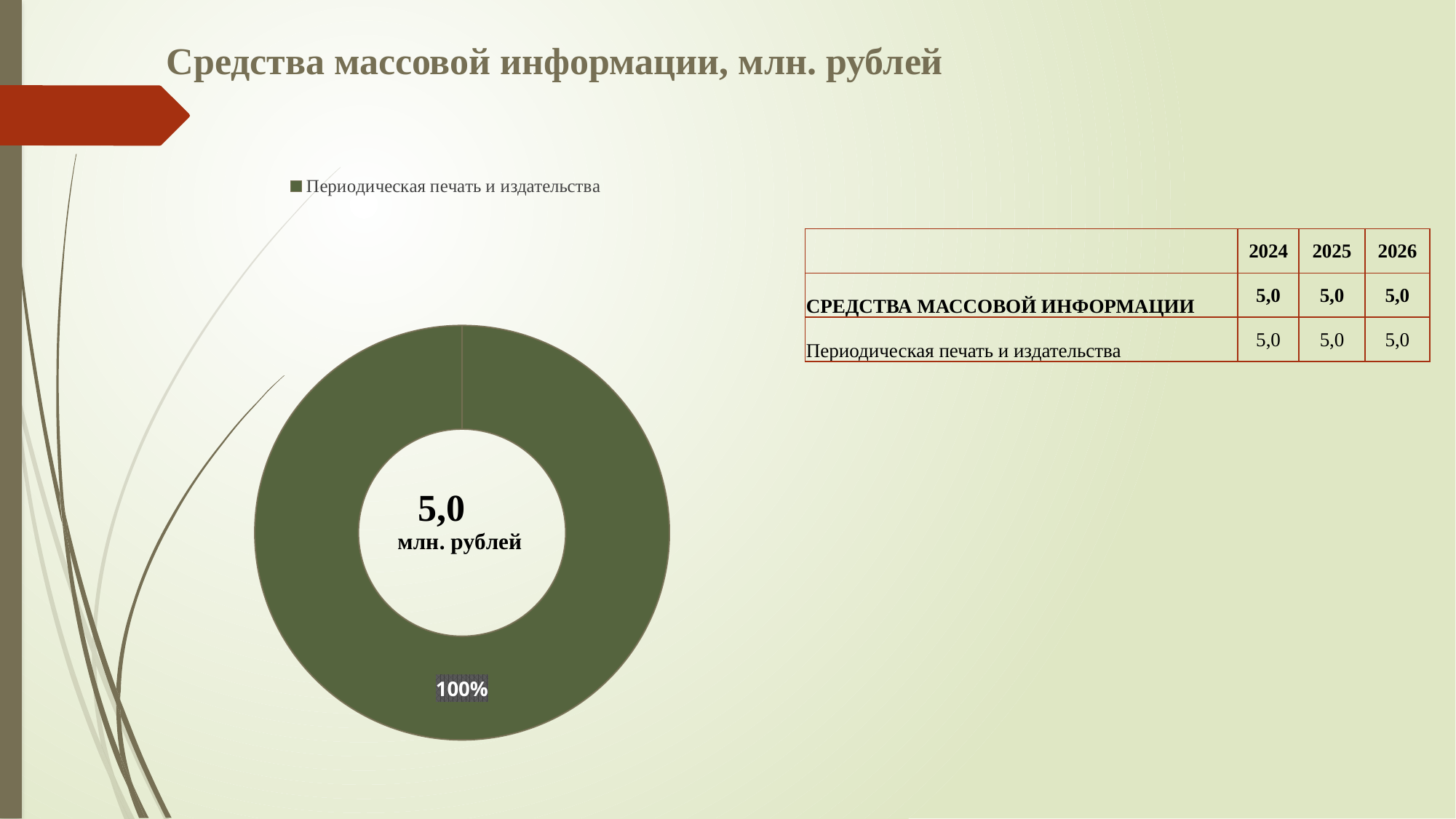
What is the name of the only category shown in the chart legend? Периодическая печать и издательства How many slices does the doughnut chart have? 1 How many entries does the chart legend list? 1 What kind of chart is shown on the slide? Doughnut chart What is the title of the slide containing the doughnut chart? Средства массовой информации, млн. рублей Which category is the largest in the doughnut chart? Периодическая печать и издательства What share of the doughnut chart does the slice "Периодическая печать и издательства" take? 100% What percentage label is printed on the doughnut slice? 100% What value is printed in the centre of the doughnut chart? 5,0 млн. рублей